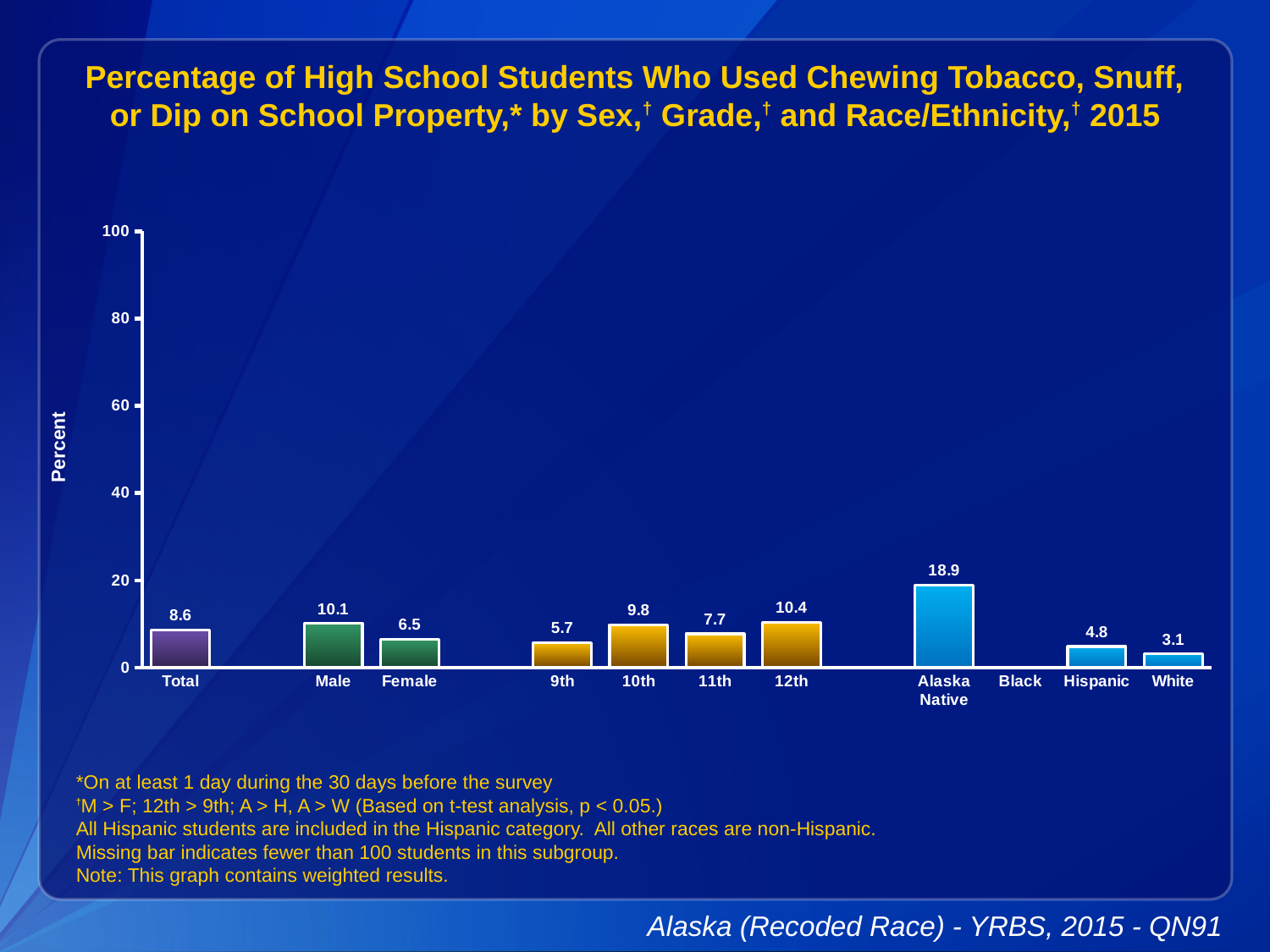
What is the value for Male? 10.1 Which is larger, the value for 12th grade or 9th grade? 12th Which category has no bar shown? Black What is the difference between the Male and Female values? 3.6 Is the value for Alaska Native greater or less than 20? less Which category with a bar has the lowest value? White How many categories have a bar plotted? 11 Which category has the highest value? Alaska Native What is the value for Alaska Native? 18.9 What is the value for Total? 8.6 What kind of chart is shown? bar chart What is the value for 11th grade? 7.7